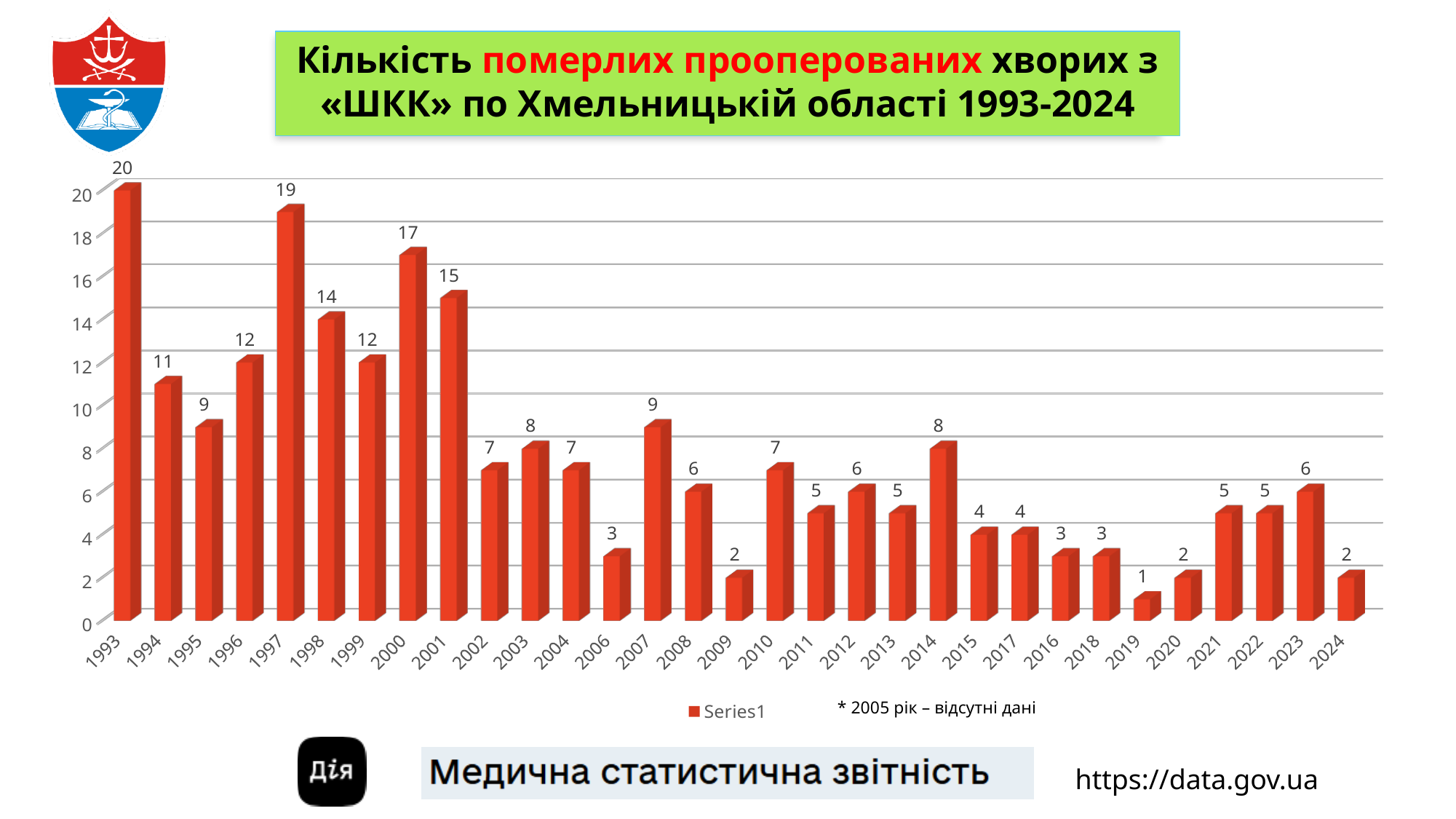
Which year has the highest value? 1993 Which year has the lowest value? 2019 What is the value for 2014? 8 Which is larger, the value for 2007 or the value for 2008? 2007 How many years are shown on the x axis? 31 How many series does the legend list? 1 What is the value for 2024? 2 What is the difference between the values for 1997 and 1998? 5 What is the value for 1993? 20 Is the value for 2001 greater or less than 10? greater What kind of chart is shown on the slide? bar chart What is the value for 2000? 17